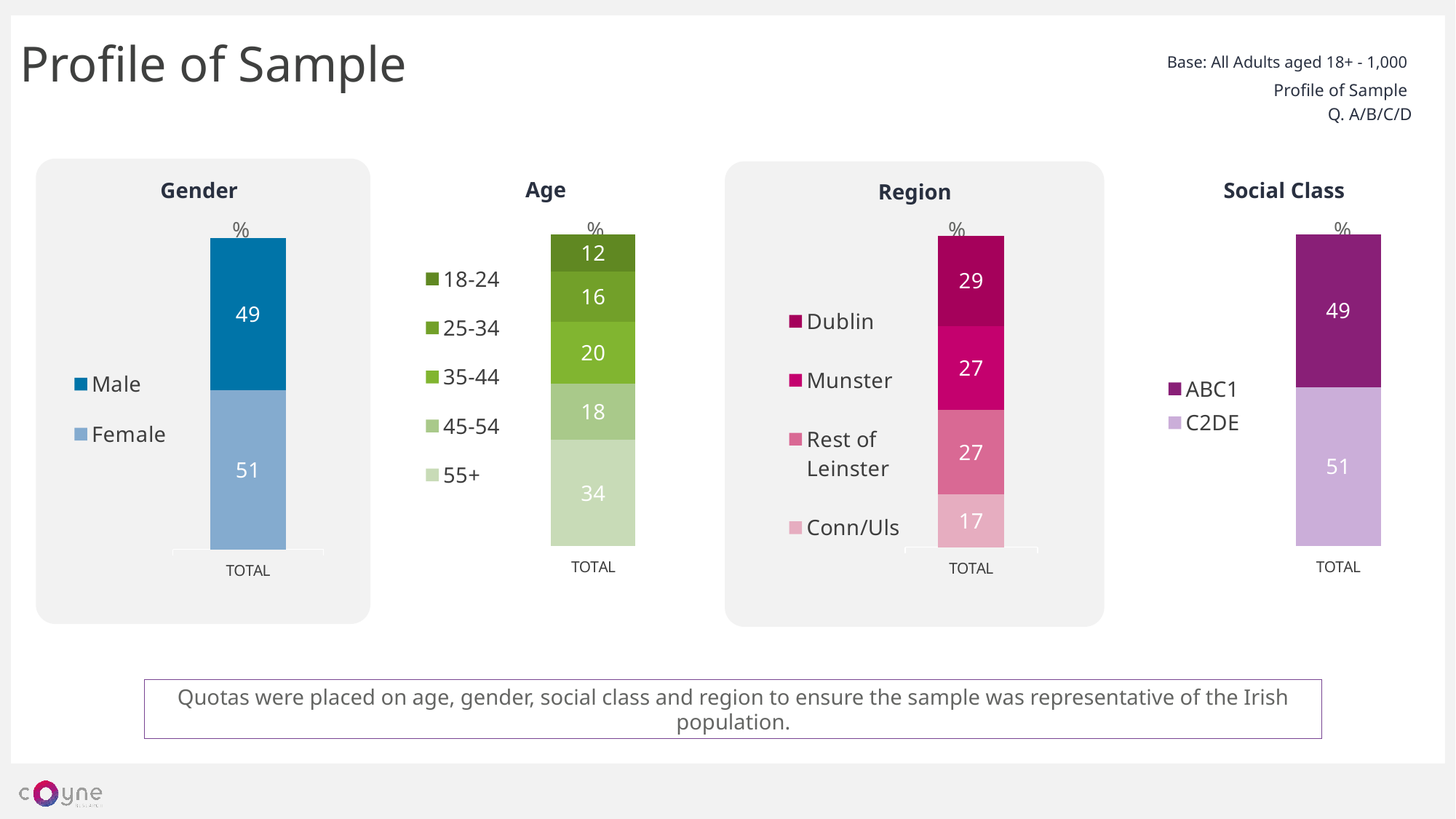
In the Gender chart, what is the value for Male? 49 In the Social Class chart, which is larger, ABC1 or C2DE? C2DE What kind of chart is the Region chart? Stacked bar chart In the Region chart, what is the total of the stacked bar? 100 In the Age chart, what is the difference between the 35-44 and 25-34 values? 4 In the Region chart, what is the value for Dublin? 29 In the Age chart, which age group has the lowest value? 18-24 In the Age chart, how many series does the legend list? 5 In the Region chart, which region has the lowest value? Conn/Uls In the Gender chart, what is the value for Female? 51 In the Age chart, what is the value for the 55+ group? 34 In the Social Class chart, what is the value for ABC1? 49